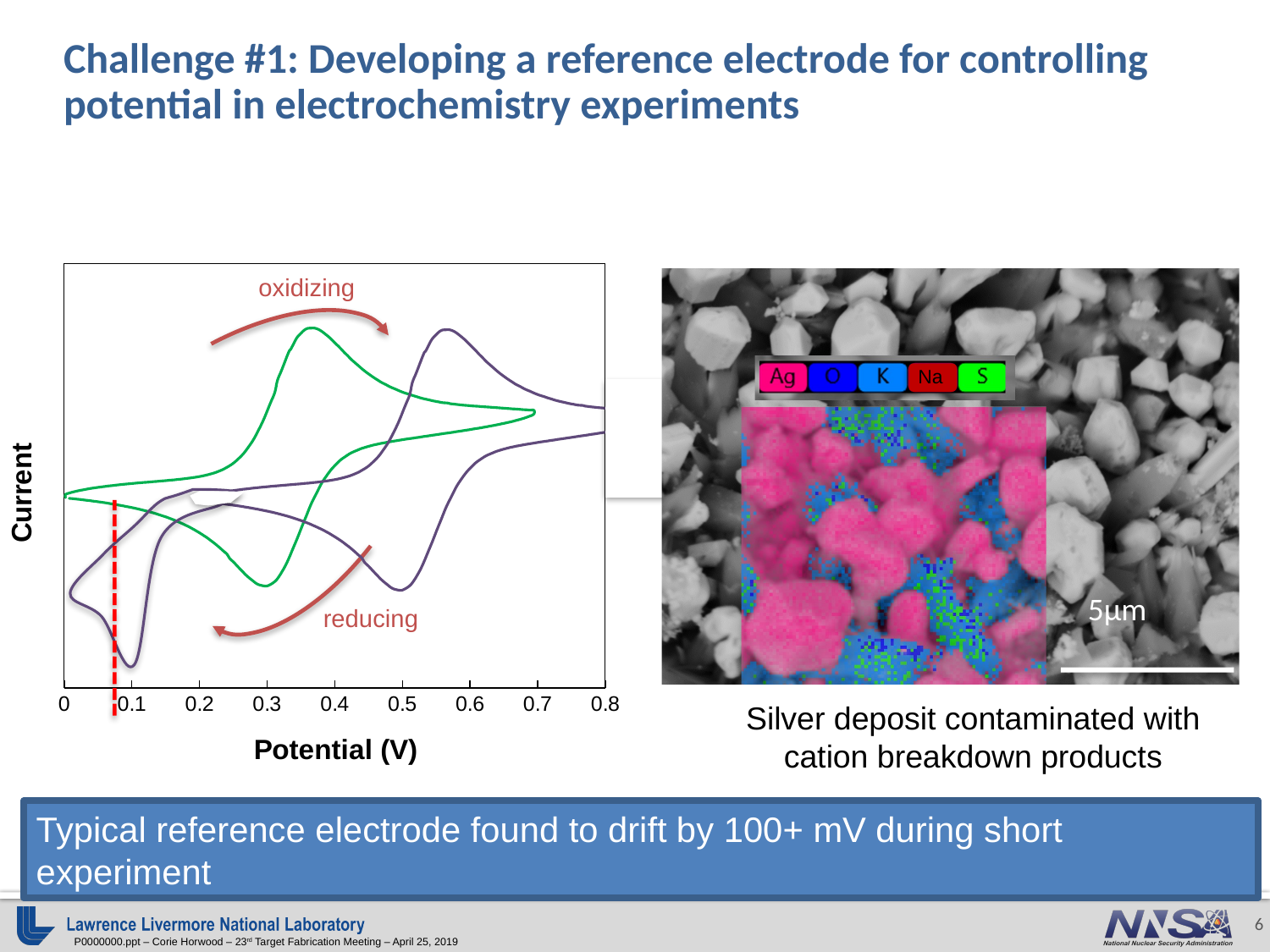
How many curves are plotted on the chart? 2 How many tick labels are shown on the x axis of the chart? 9 What is the label of the y axis of the chart? Current Which curve reaches its upper peak at a higher potential, the green curve or the purple curve? purple curve What is the lowest tick value shown on the x axis of the chart? 0 Is the potential at which the purple curve reaches its upper peak greater or less than 0.5 V? greater Is the potential marked by the red dashed vertical line greater or less than 0.2 V? less What kind of chart is shown on the left of the slide? line chart Which curve reaches its lowest point at a lower potential, the green curve or the purple curve? purple curve Is the potential at which the green curve reaches its upper peak greater or less than 0.5 V? less What is the highest tick value shown on the x axis of the chart? 0.8 What is the label of the x axis of the chart? Potential (V)